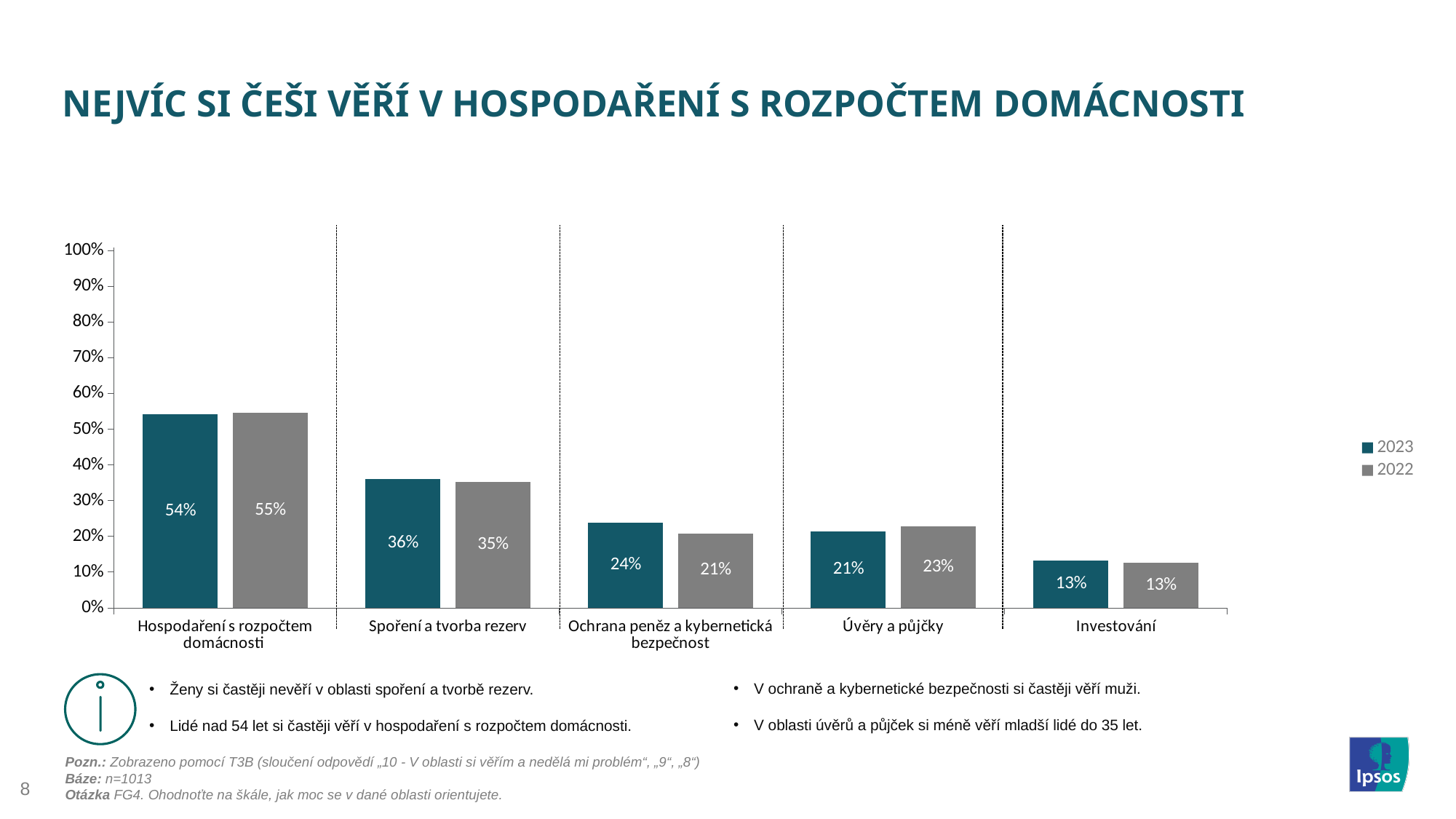
What is the 2022 value for Úvěry a půjčky? 23% What is the 2022 value for Spoření a tvorba rezerv? 35% Is the 2023 value for Spoření a tvorba rezerv greater or less than 30%? greater What is the 2023 value for Ochrana peněz a kybernetická bezpečnost? 24% What is the 2023 value for Hospodaření s rozpočtem domácnosti? 54% How many categories are shown on the x axis? 5 Which category has the lowest 2022 value? Investování How many series does the legend list? 2 What kind of chart is shown on the slide? Bar chart What is the difference between the 2023 and 2022 values for Ochrana peněz a kybernetická bezpečnost? 3 percentage points Which is larger for Úvěry a půjčky, the 2023 value or the 2022 value? 2022 Which category has the highest 2023 value? Hospodaření s rozpočtem domácnosti